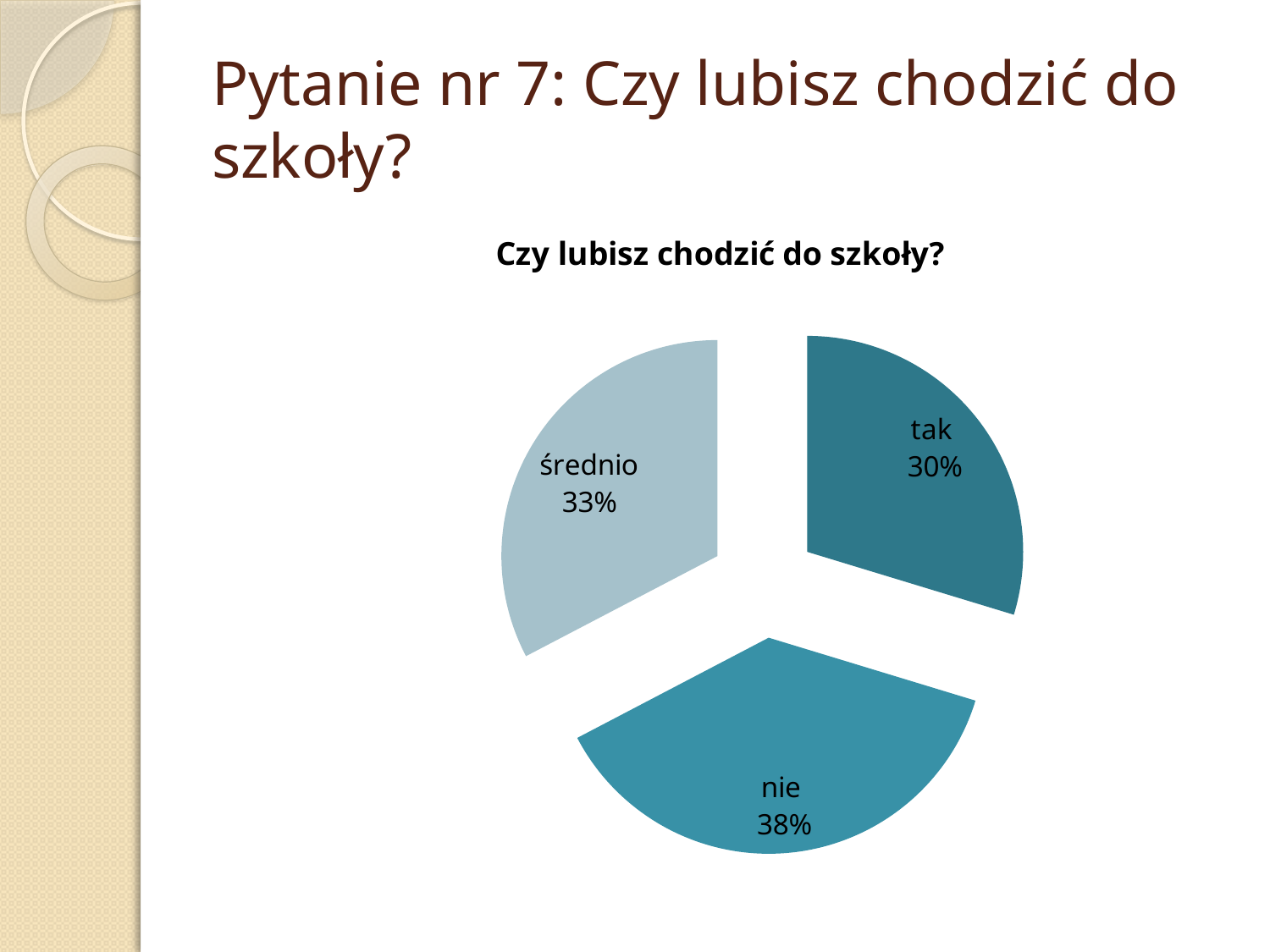
What is the difference in percentage points between the "średnio" and "tak" slices? 3 Which slice is the darkest shade of blue? tak What share of the pie does the "nie" slice represent? 38% What kind of chart is shown on the slide? pie chart Which category has the largest share of the pie? nie What is the difference in percentage points between the "nie" and "tak" slices? 8 Which is larger, the "średnio" slice or the "nie" slice? nie How many slices does the pie chart have? 3 What is the title of the chart? Czy lubisz chodzić do szkoły? What share of the pie does the "tak" slice represent? 30% What share of the pie does the "średnio" slice represent? 33% Which category has the smallest share of the pie? tak